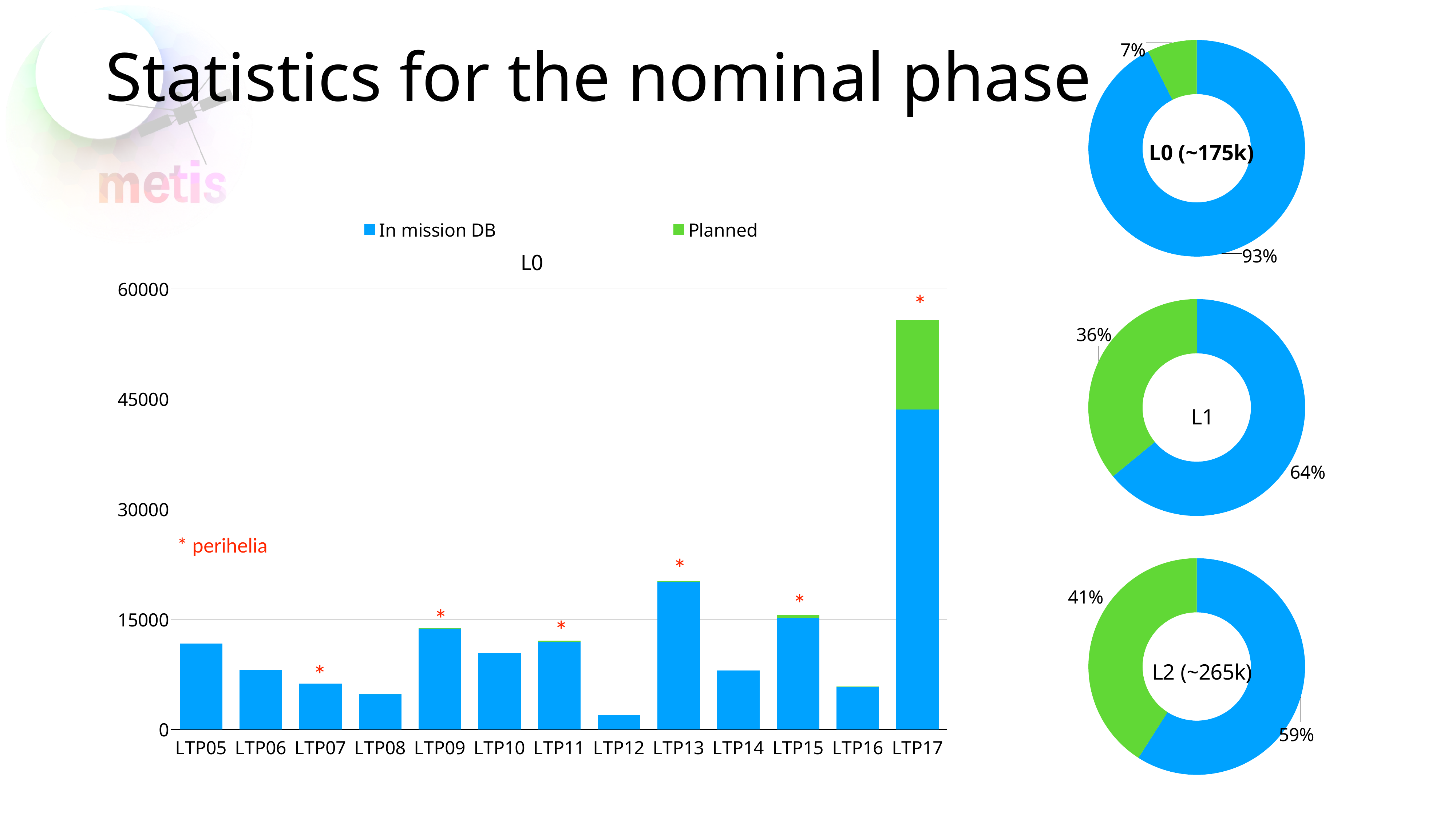
What kind of chart is the L0 chart on the left of the slide? bar chart In the L0 bar chart, which category has the shortest bar? LTP12 In the L0 bar chart, is the bar for LTP13 greater or less than 15000? greater In the L2 (~265k) donut chart, what share is shown for the blue (In mission DB) slice? 59% In the L0 bar chart, is the total bar for LTP17 greater or less than 45000? greater In the L0 bar chart, which category has the tallest bar? LTP17 How many categories are shown on the x axis of the L0 bar chart? 13 In the L1 donut chart, what share is shown for the green (Planned) slice? 36% How many series does the legend of the L0 bar chart list? 2 In the L0 bar chart, is the bar for LTP08 greater or less than 15000? less In the L0 bar chart, which bar is taller, LTP09 or LTP06? LTP09 In the L0 (~175k) donut chart at the top right, what share is shown for the blue (In mission DB) slice? 93%